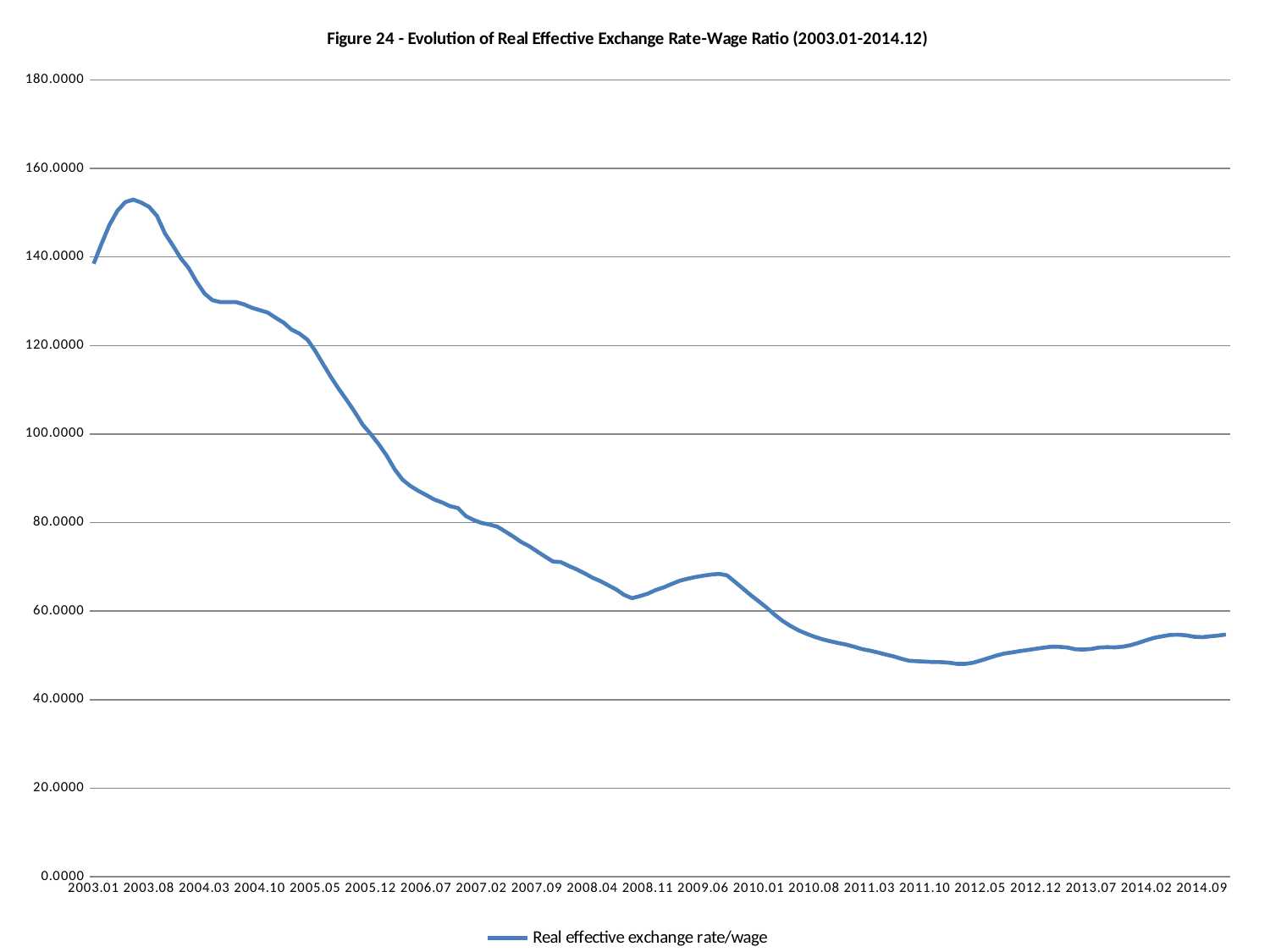
Overall, does the real effective exchange rate/wage ratio rise or fall from 2003.01 to 2014.09? fall What is the title of the chart? Figure 24 - Evolution of Real Effective Exchange Rate-Wage Ratio (2003.01-2014.12) Which is larger, the value at 2009.06 or the value at 2010.08? 2009.06 What is the name of the series shown in the legend? Real effective exchange rate/wage Is the value for 2007.09 greater or less than 80? less Is the value for 2011.10 greater or less than 60? less Is the value for 2006.07 greater or less than 100? less How many series does the legend list? 1 What kind of chart is shown on the slide? line chart Near which x-axis label does the line reach its highest value? 2003.08